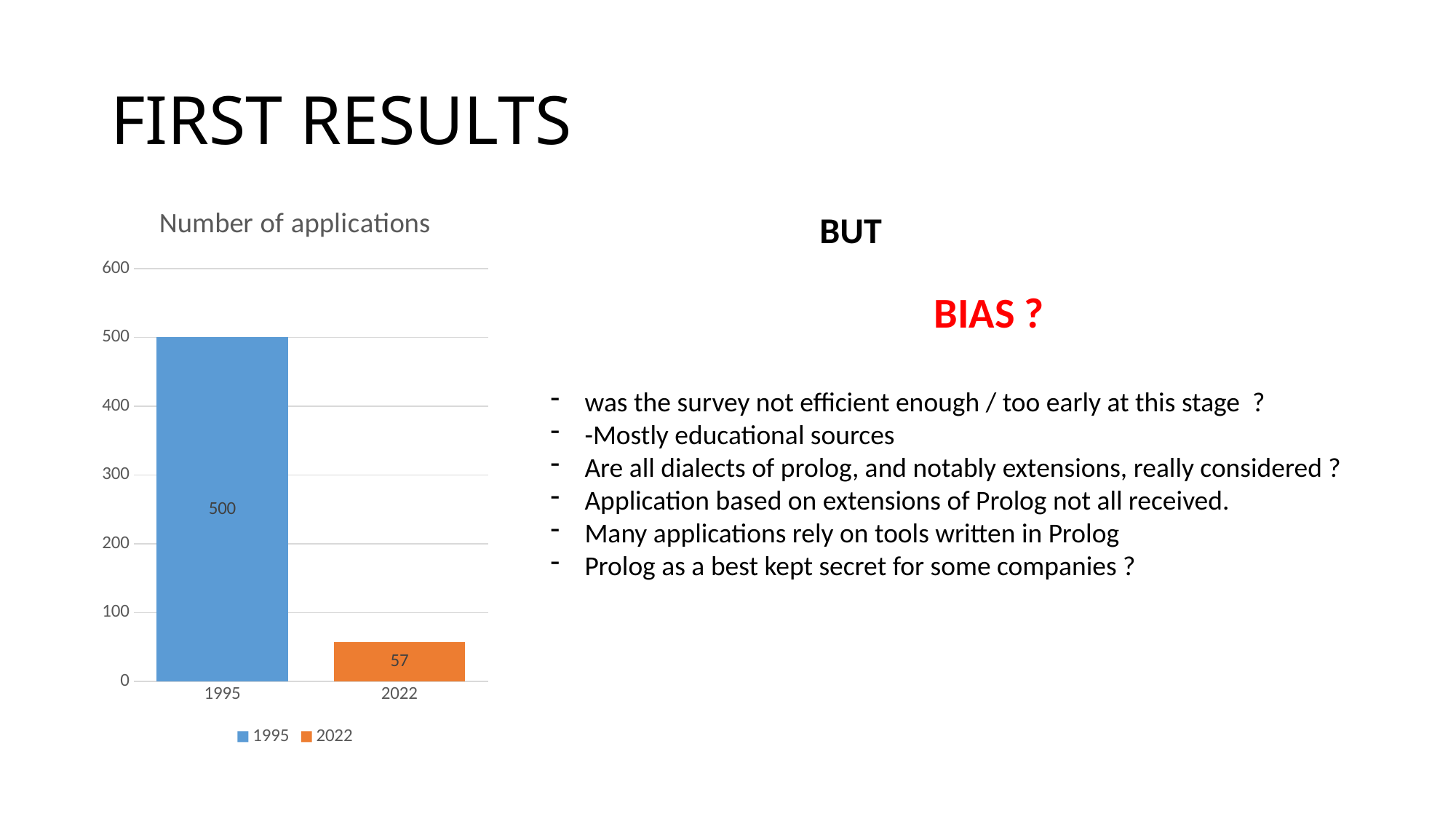
Which year has the lowest number of applications? 2022 What is the difference between the number of applications in 1995 and in 2022? 443 What is the number of applications for 1995? 500 Which year has the highest number of applications? 1995 Is the value for 2022 greater or less than 100? less How many entries does the chart legend list? 2 Which is larger, the value for 1995 or the value for 2022? 1995 How many categories are shown on the x axis of the chart? 2 What is the title of the chart? Number of applications What is the number of applications for 2022? 57 Do the values rise or fall from 1995 to 2022? fall What kind of chart is shown on the slide? bar chart